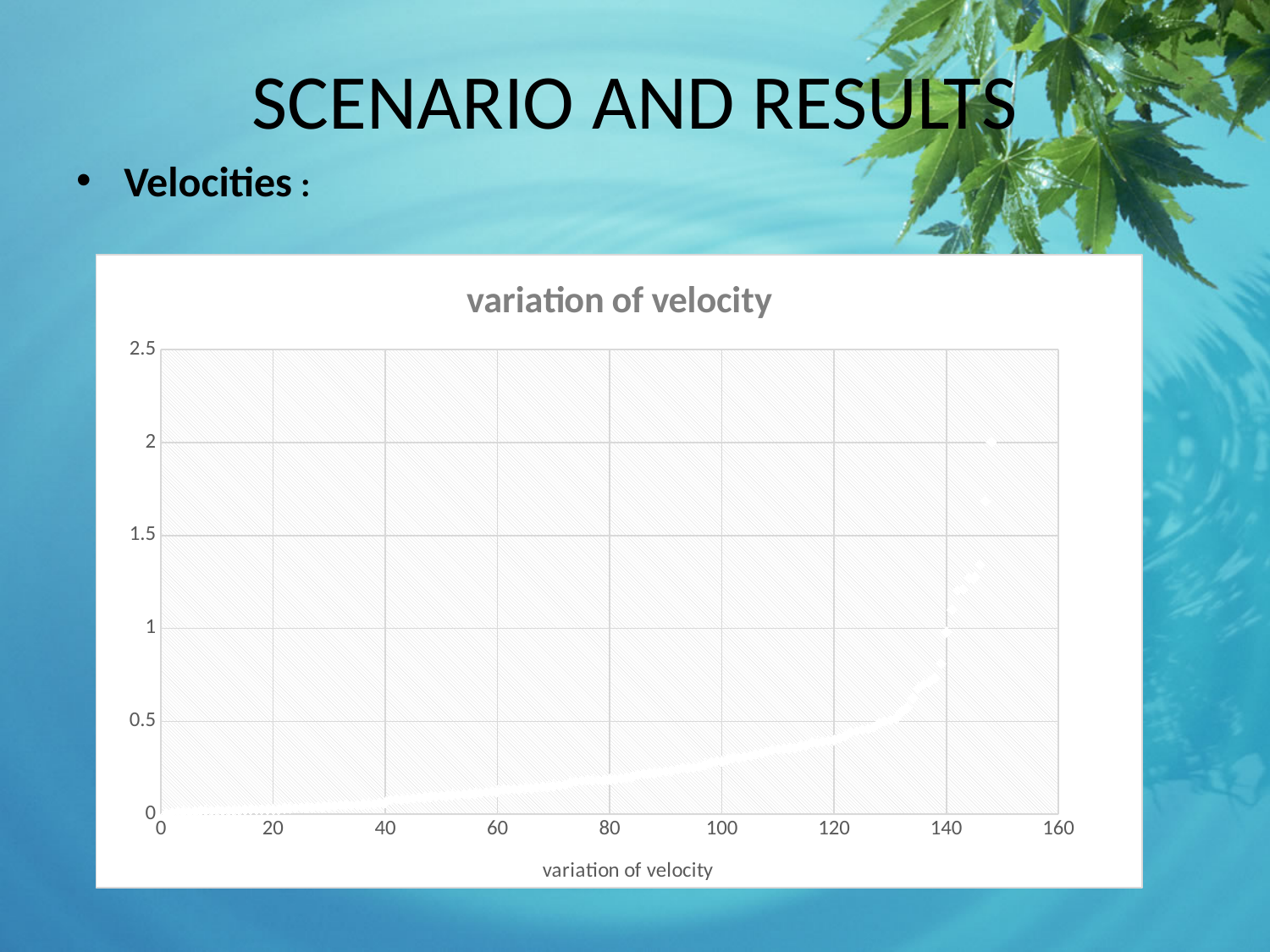
Do the plotted values rise or fall as the x axis increases? rise Is the plotted value at x = 80 greater or less than 1? less Is the plotted value at x = 60 greater or less than 0.5? less What is the maximum value shown on the chart's vertical axis? 2.5 What is the title of the chart? variation of velocity Is the plotted value at x = 100 greater or less than 0.5? less How many series does the chart's legend list? 1 What kind of chart is shown on the slide? scatter chart